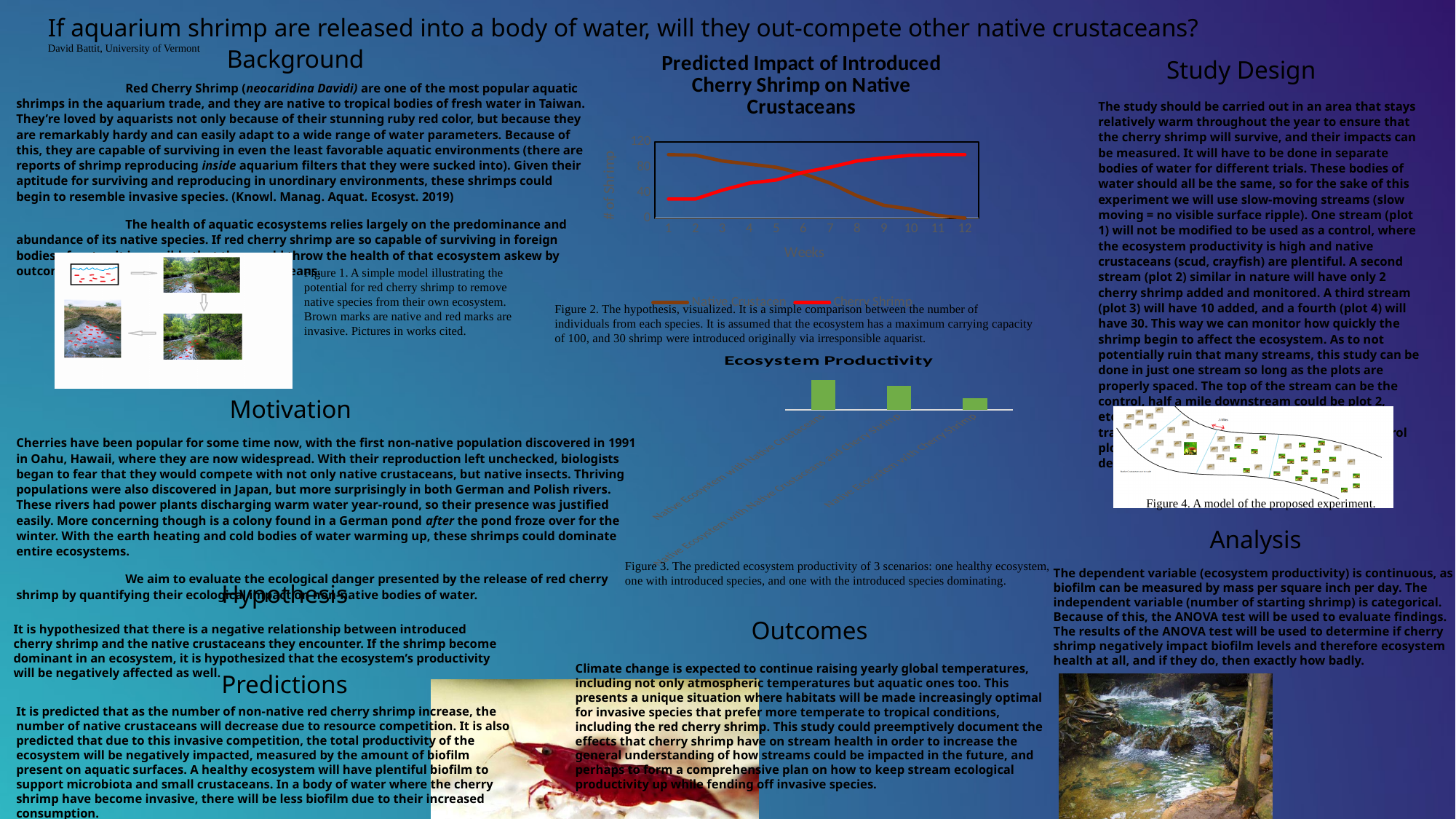
In the 'Predicted Impact of Introduced Cherry Shrimp on Native Crustaceans' chart, does the Native Crustaceans line rise or fall across the weeks? fall In the 'Predicted Impact of Introduced Cherry Shrimp on Native Crustaceans' chart, which series has the higher value at week 12? Cherry Shrimp In the 'Predicted Impact of Introduced Cherry Shrimp on Native Crustaceans' chart, is the Native Crustaceans value at week 1 greater or less than 80? greater In the 'Predicted Impact of Introduced Cherry Shrimp on Native Crustaceans' chart, how many weeks are shown on the x axis? 12 How many bars are shown in the 'Ecosystem Productivity' chart? 3 In the 'Predicted Impact of Introduced Cherry Shrimp on Native Crustaceans' chart, is the Cherry Shrimp value at week 1 greater or less than 40? less In the 'Predicted Impact of Introduced Cherry Shrimp on Native Crustaceans' chart, is the Native Crustaceans value at week 12 greater or less than 40? less What kind of chart is the 'Predicted Impact of Introduced Cherry Shrimp on Native Crustaceans' chart? line chart In the 'Predicted Impact of Introduced Cherry Shrimp on Native Crustaceans' chart, does the Cherry Shrimp line rise or fall across the weeks? rise How many series does the legend of the 'Predicted Impact of Introduced Cherry Shrimp on Native Crustaceans' chart list? 2 In the 'Predicted Impact of Introduced Cherry Shrimp on Native Crustaceans' chart, what are the two series named in the legend? Native Crustacen and Cherry Shrimp What kind of chart is the 'Ecosystem Productivity' chart? bar chart